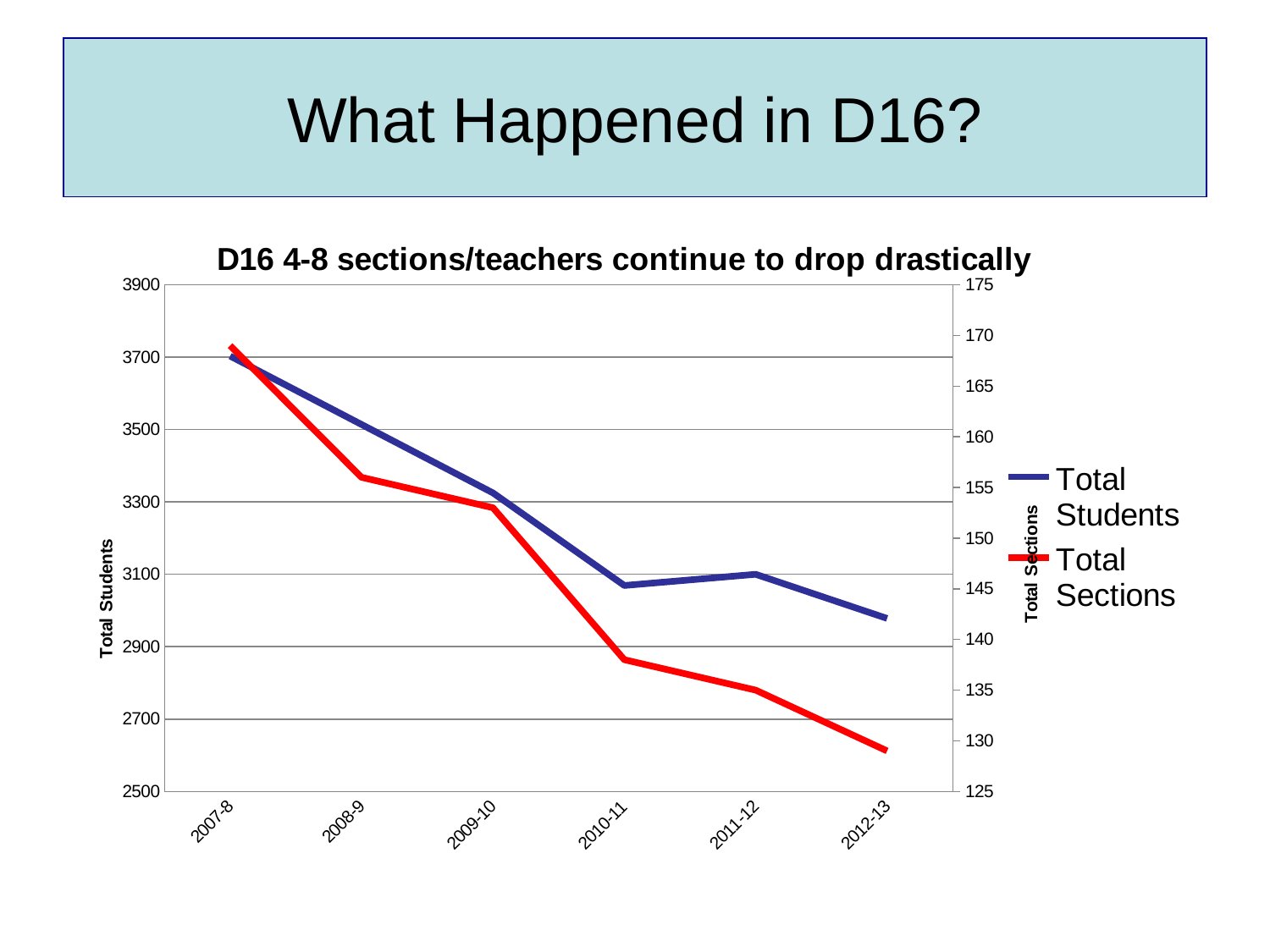
Is the value for Total Sections in 2012-13 greater or less than 135? less Is the value for Total Students in 2012-13 greater or less than 3100? less How many series does the legend list? 2 In which school year is Total Sections lowest? 2012-13 In which school year is Total Sections highest? 2007-8 Overall, do the Total Sections values rise or fall from 2007-8 to 2012-13? fall What kind of chart is shown on the slide? line chart How many school years are plotted along the x axis? 6 In which school year is Total Students highest? 2007-8 Is the value for Total Sections in 2007-8 greater or less than 165? greater What is the title of the chart? D16 4-8 sections/teachers continue to drop drastically In which school year is Total Students lowest? 2012-13